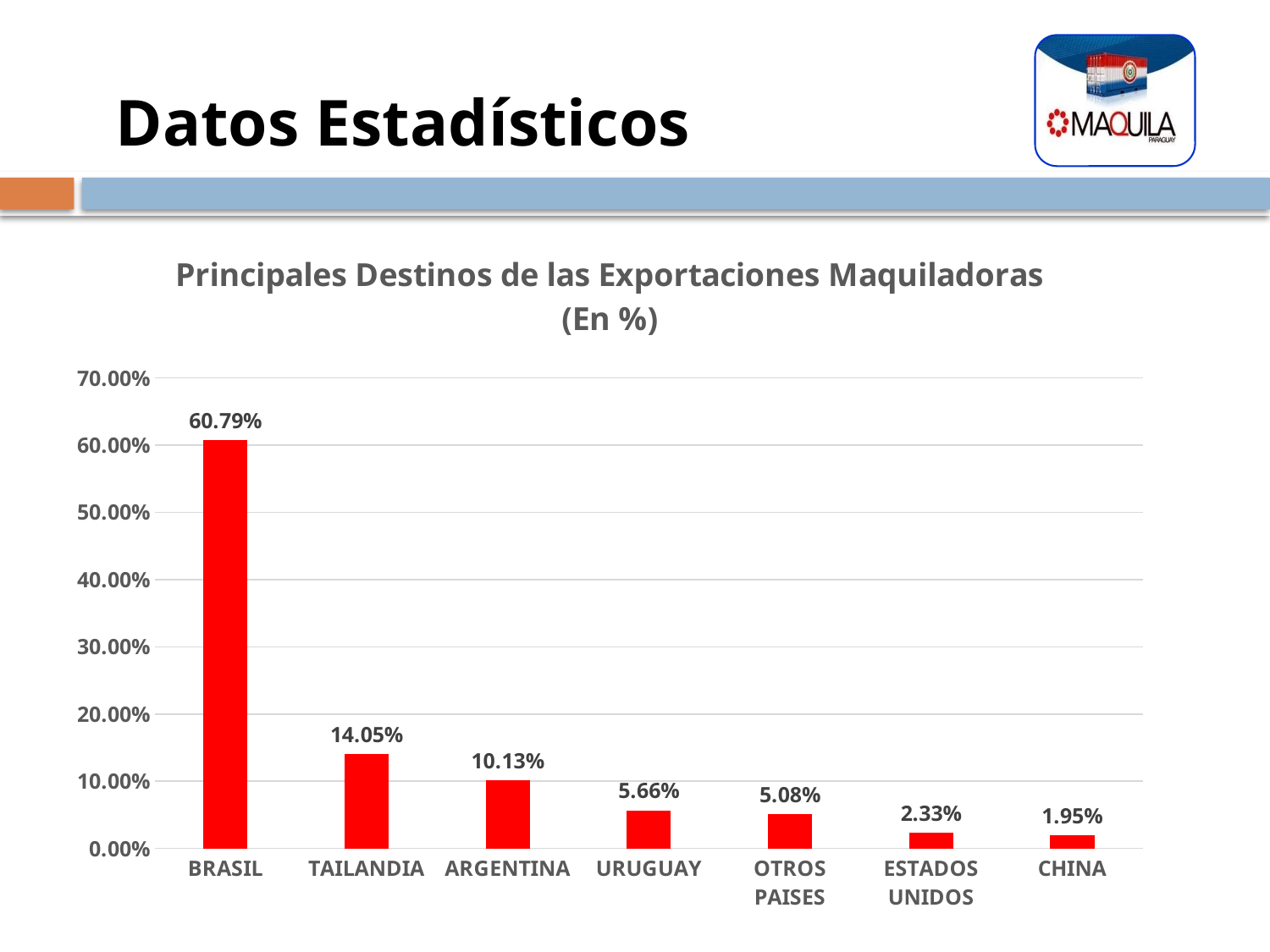
What is the value for BRASIL? 60.79% What is the value for TAILANDIA? 14.05% What is the title of the chart? Principales Destinos de las Exportaciones Maquiladoras (En %) Is the value for ARGENTINA greater or less than 10.00%? greater What is the difference between the values for BRASIL and TAILANDIA? 46.74% Which destination has the lowest value? CHINA What is the difference between the values for ARGENTINA and URUGUAY? 4.47% What is the value for ESTADOS UNIDOS? 2.33% Which destination has the highest value? BRASIL Which is larger, the value for URUGUAY or the value for OTROS PAISES? URUGUAY How many destinations are shown on the chart? 7 What kind of chart is shown on the slide? bar chart